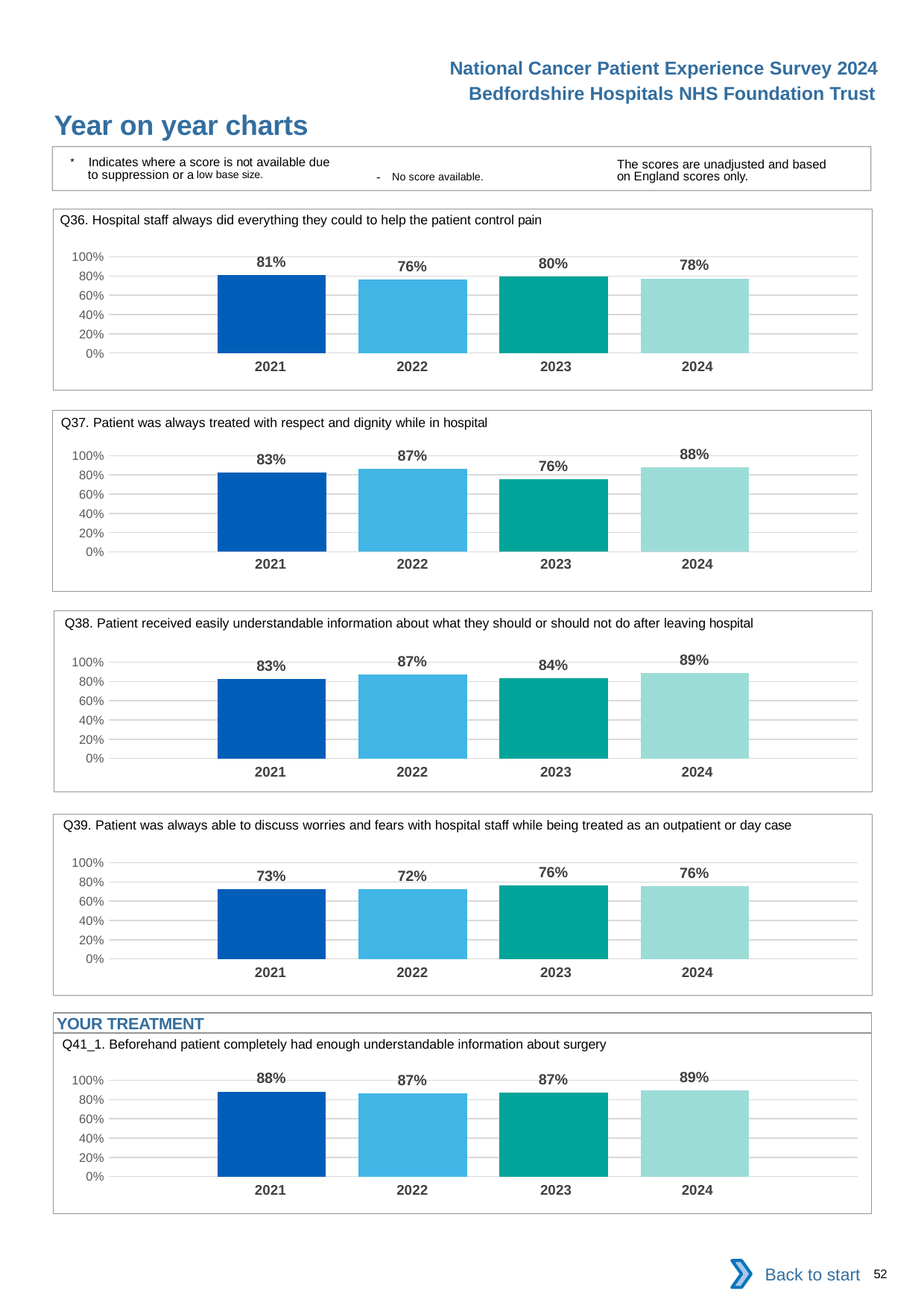
In the Q39 chart (discuss worries and fears as an outpatient), is the value for 2022 greater or less than 80%? less In the Q37 chart (treated with respect and dignity), which year has the lowest value? 2023 In the Q38 chart (understandable information after leaving hospital), which is larger, the 2022 value or the 2023 value? 2022 In the Q41_1 chart (information about surgery), what is the difference between the 2021 and 2022 values? 1 percentage point How many years are shown in the Q36 chart (hospital staff helped control pain)? 4 In the Q39 chart (discuss worries and fears as an outpatient), what is the value for 2021? 73% In the Q41_1 chart (information about surgery), which year has the highest value? 2024 What type of chart is the Q37 chart (treated with respect and dignity)? Bar chart In the Q38 chart (understandable information after leaving hospital), what is the value for 2024? 89% In the Q37 chart (treated with respect and dignity), what is the difference between the 2024 and 2023 values? 12 percentage points In the Q36 chart (hospital staff helped control pain), what is the value for 2022? 76% In the Q36 chart (hospital staff helped control pain), which year has the highest value? 2021